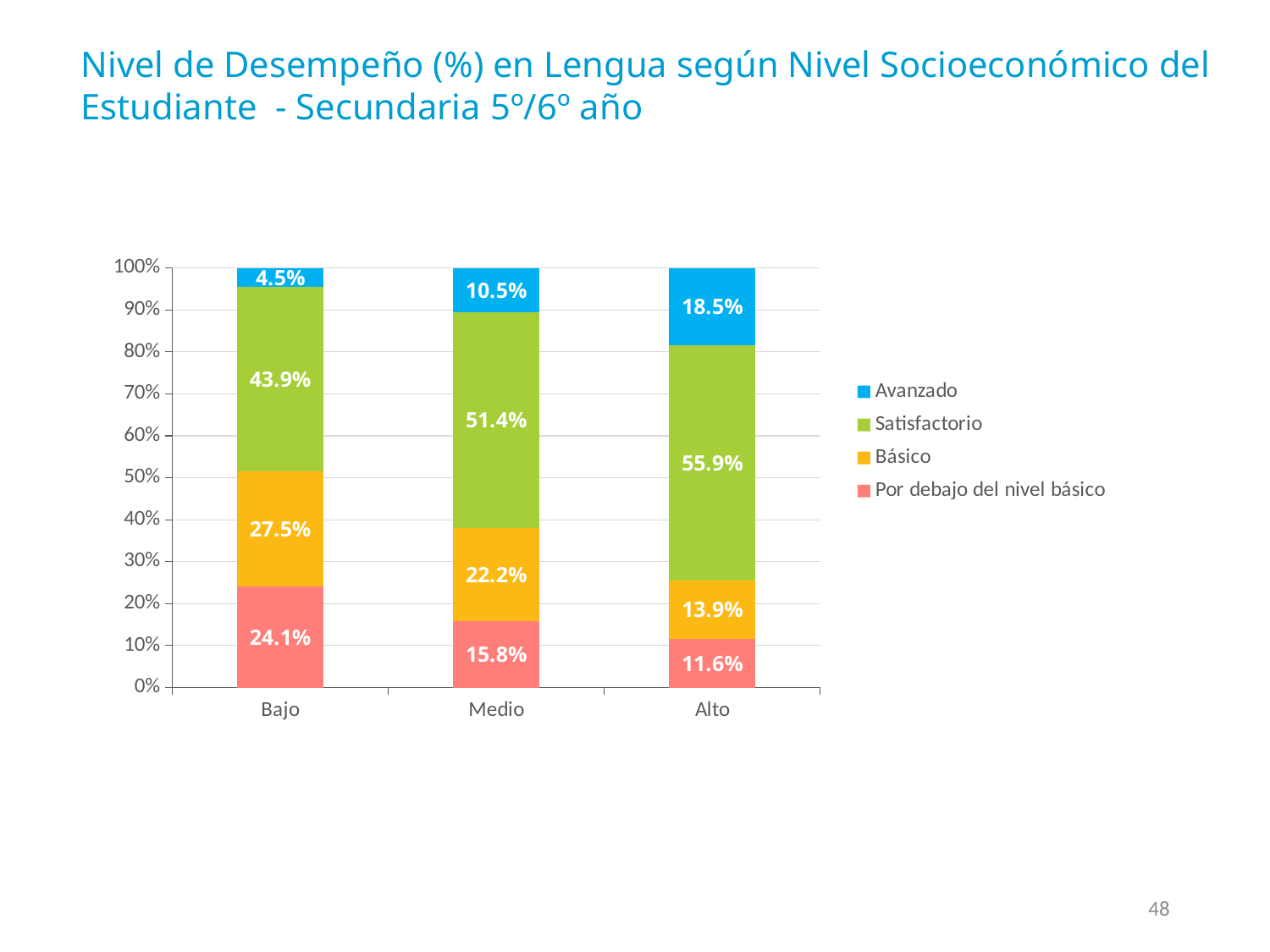
What is the Básico value for the Alto category? 13.9% What is the difference between the Satisfactorio values for Alto and Bajo? 12.0% How many categories are shown on the x axis? 3 What is the Por debajo del nivel básico value for the Bajo category? 24.1% Which category has the highest Avanzado value? Alto Do the Avanzado values rise or fall from Bajo to Alto? Rise Which is larger, the Básico value for Bajo or the Básico value for Medio? Bajo What kind of chart is shown on the slide? Stacked bar chart What is the Satisfactorio value for the Medio category? 51.4% What is the Avanzado value for the Alto category? 18.5% Which category has the lowest Por debajo del nivel básico value? Alto How many series does the legend list? 4